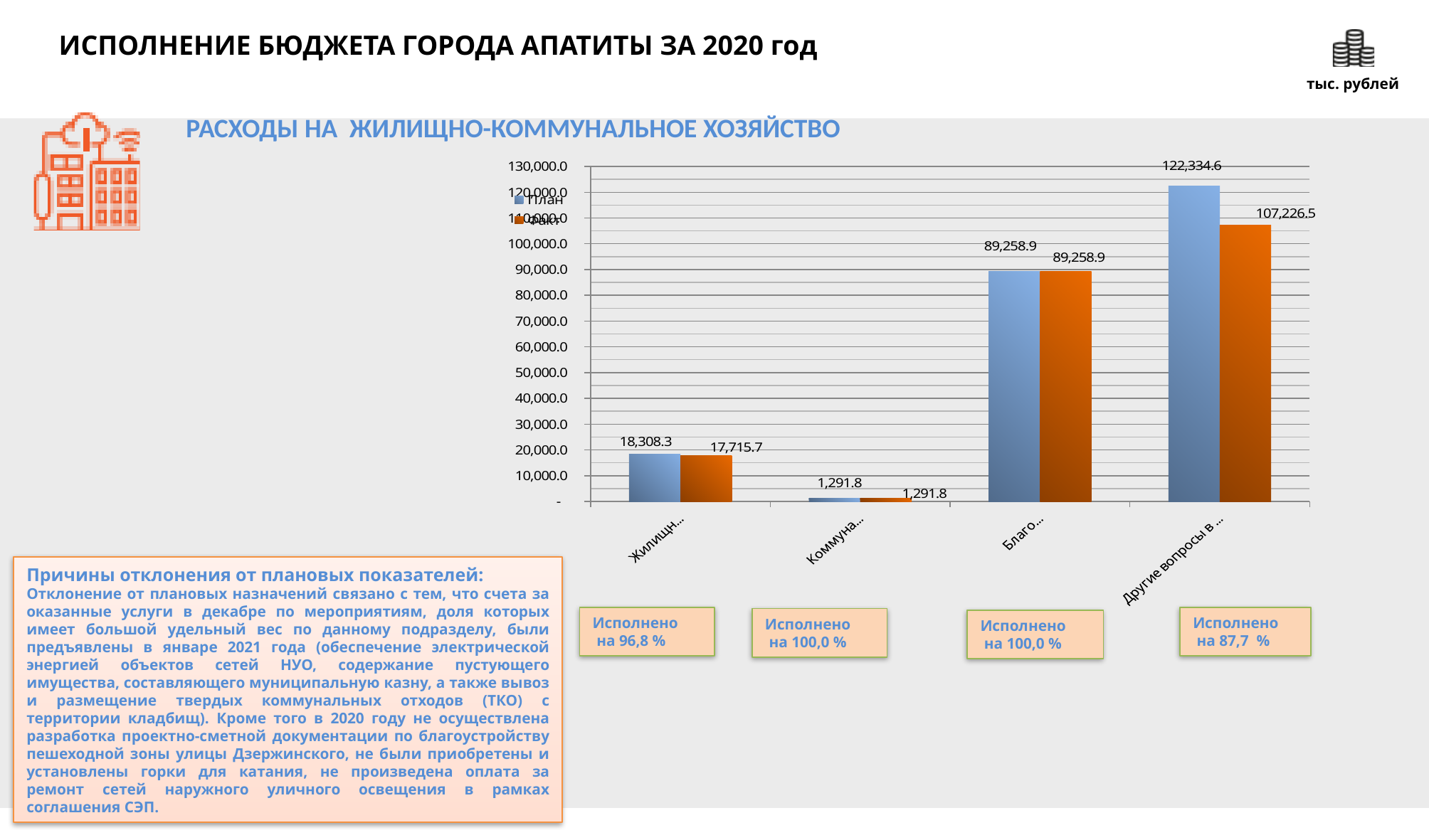
What is the difference between the План and Факт values for the rightmost category, 'Другие вопросы в ...'? 15,108.1 What kind of chart is shown on the slide? bar chart What is the Факт (actual) value for the first category on the left of the chart? 17,715.7 What is the План value for the fourth (rightmost) category, 'Другие вопросы в ...'? 122,334.6 What is the Факт value for the third category, 'Благо...'? 89,258.9 What is the Факт value for the fourth (rightmost) category, 'Другие вопросы в ...'? 107,226.5 How many series does the chart legend list? 2 Which category has the lowest Факт value? Коммуна... (the second category) What is the План (plan) value for the first category on the left of the chart? 18,308.3 How many categories are plotted along the x axis of the chart? 4 Which series is shown in orange in the chart? Факт Which category has the highest План value? Другие вопросы в ... (the fourth category)